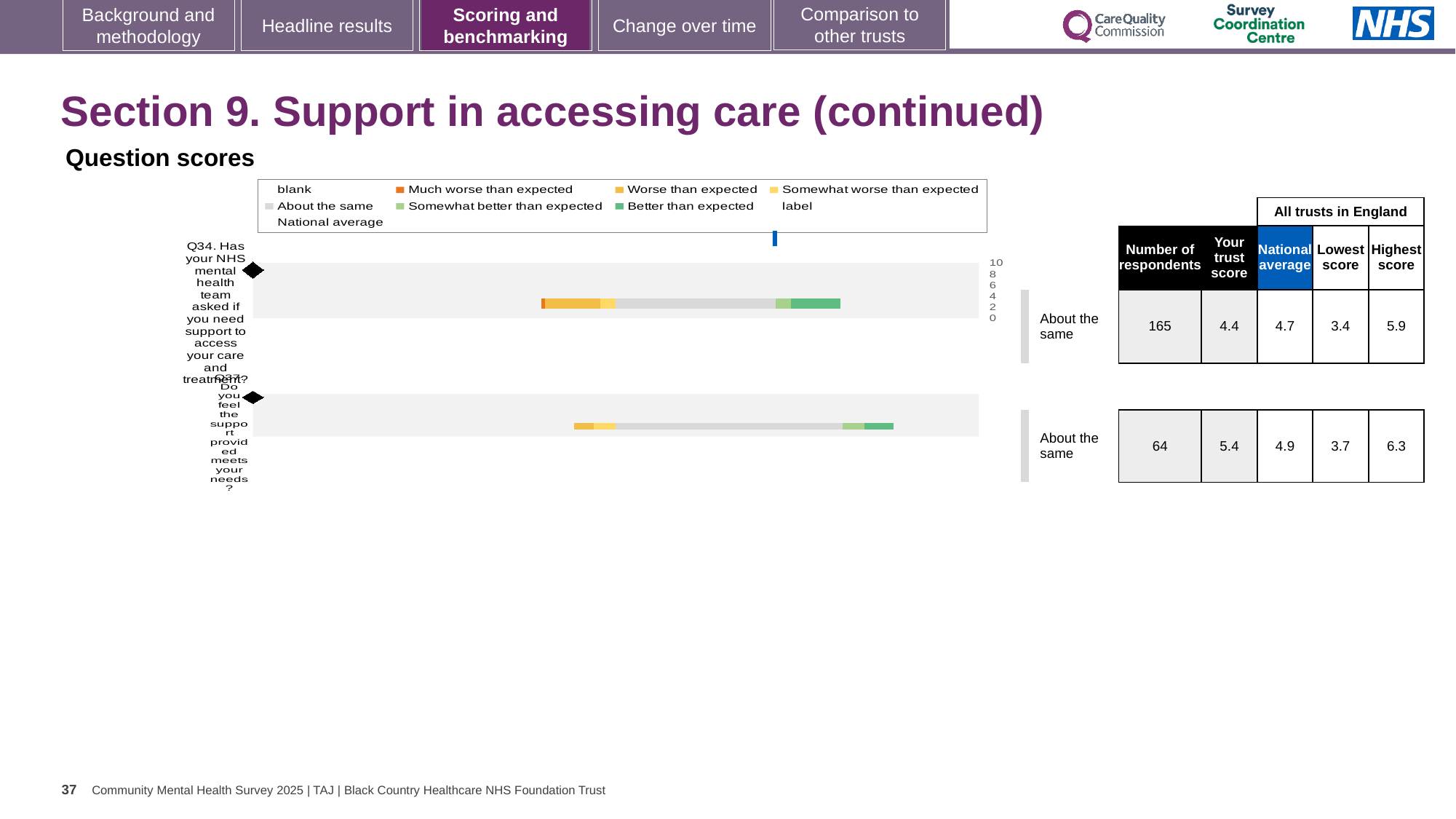
According to the table beside the chart, what is the trust score for Q34 (Has your NHS mental health team asked if you need support to access your care and treatment)? 4.4 What colour does the legend use for 'Better than expected'? green For Q34, which is larger: the trust score or the national average? national average By how much does the national average for Q34 exceed the trust score for Q34? 0.3 What is the national average score for Q37? 4.9 Which question has the higher trust score, Q34 or Q37? Q37 How many respondents answered Q34? 165 What benchmark category is shown for Q34 next to the chart? About the same What kind of chart is used to show the question scores on this slide? bar chart What is the difference between the highest score and the lowest score for Q37? 2.6 How many questions are plotted in the question scores chart? 2 According to the table beside the chart, what is the trust score for Q37 (Do you feel the support provided meets your needs)? 5.4